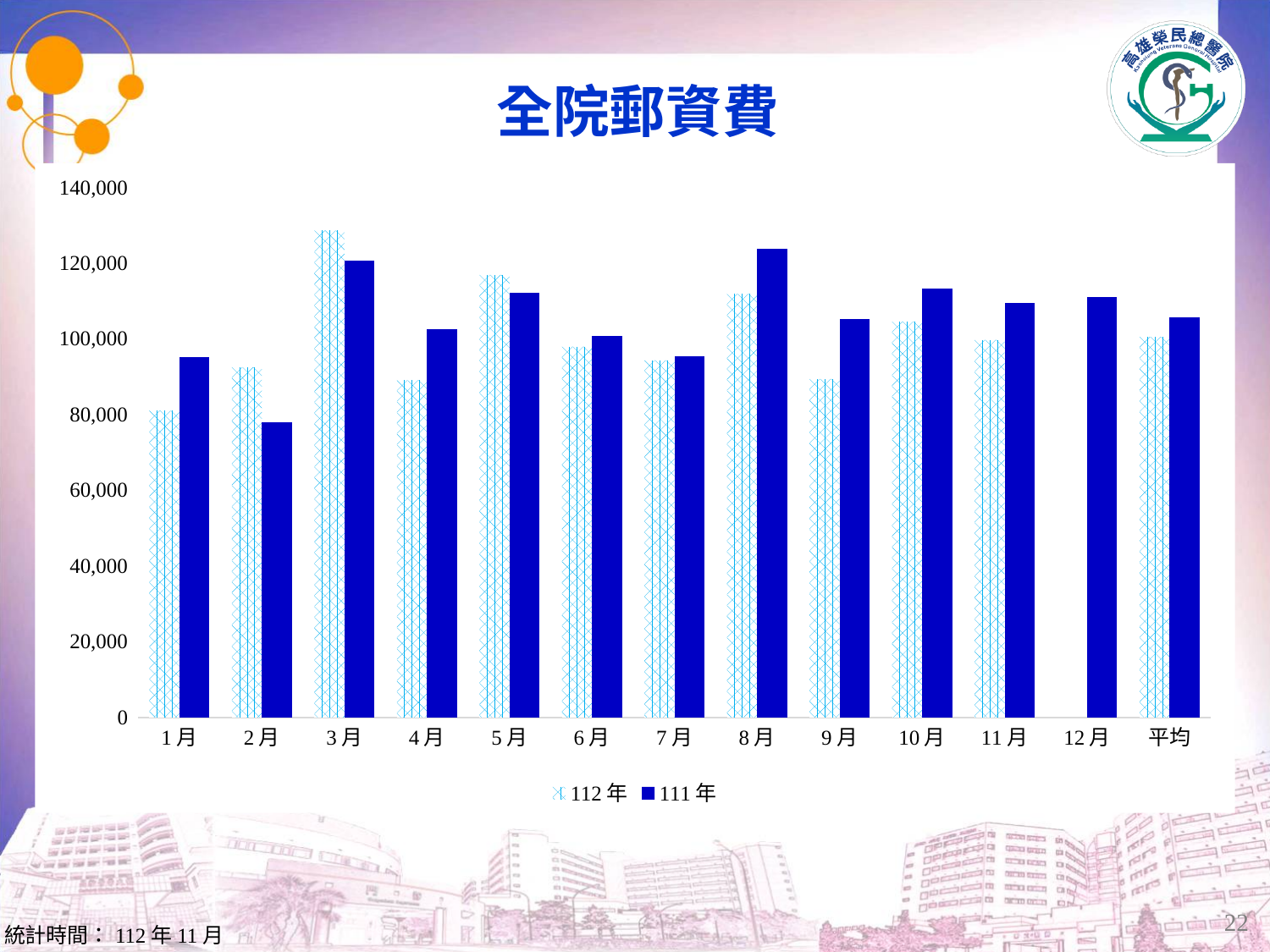
How many series does the legend list? 2 Is the 112年 value for 3月 greater or less than 120,000? greater What kind of chart is shown on the slide? bar chart Which month has no bar for the 112年 series? 12月 For 9月, which series has the larger value, 112年 or 111年? 111年 Is the 111年 value for 2月 greater or less than 80,000? less Which category has the lowest value for the 111年 series? 2月 How many categories are shown on the x axis? 13 For 2月, which series has the larger value, 112年 or 111年? 112年 Which category has the highest value for the 111年 series? 8月 Which category has the lowest value for the 112年 series? 1月 Which category has the highest value for the 112年 series? 3月